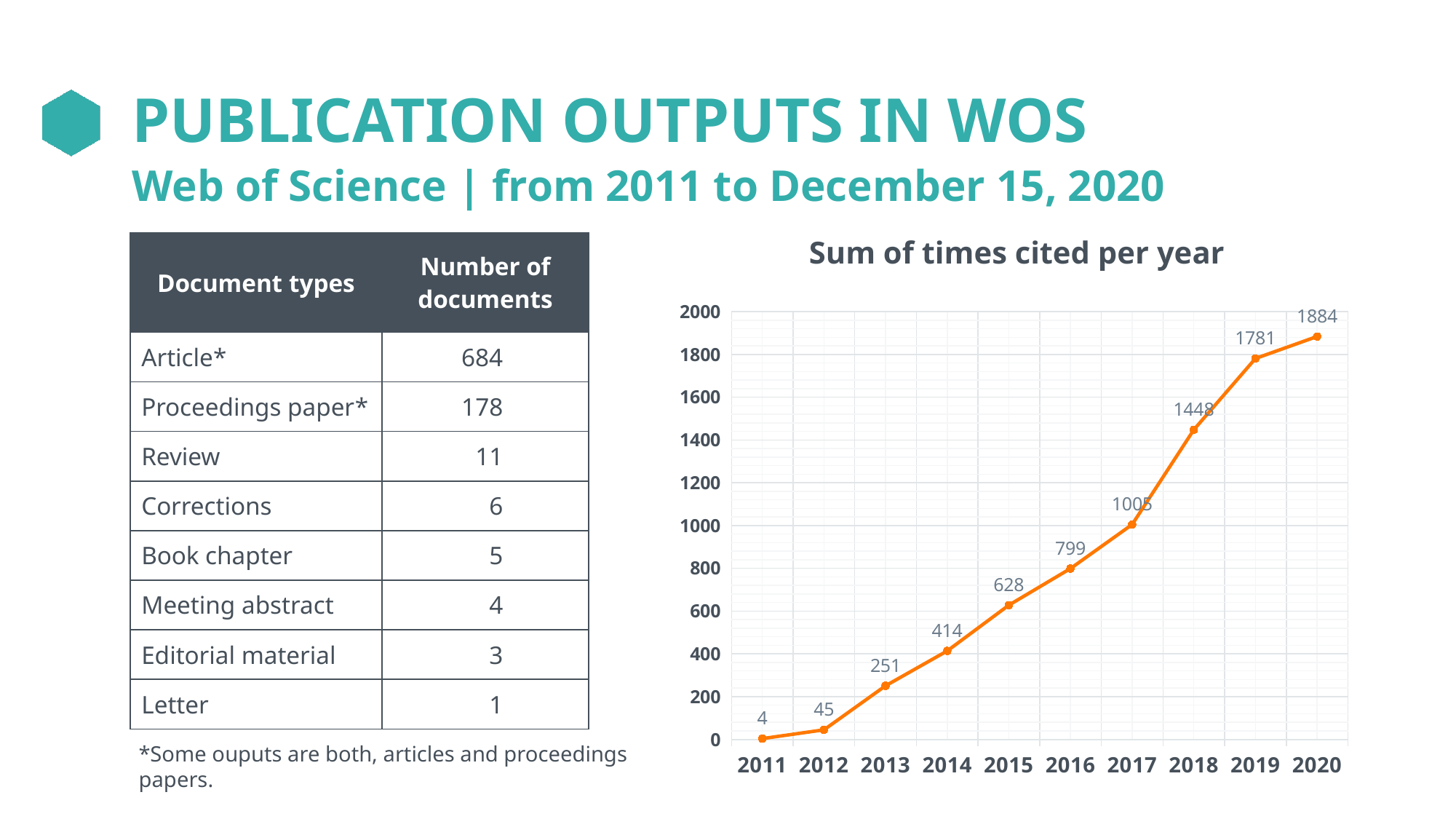
What is the sum of times cited in 2020? 1884 What kind of chart is shown on the slide? line chart Which year has a larger sum of times cited, 2014 or 2016? 2016 Does the sum of times cited rise or fall from 2011 to 2020? rise What is the difference between the sum of times cited in 2019 and in 2018? 333 What is the sum of times cited in 2013? 251 Which year has the highest sum of times cited? 2020 What is the difference between the sum of times cited in 2016 and in 2015? 171 How many years are plotted on the chart? 10 Which year has the lowest sum of times cited? 2011 Is the sum of times cited in 2018 greater or less than 1400? greater What is the sum of times cited in 2017? 1005